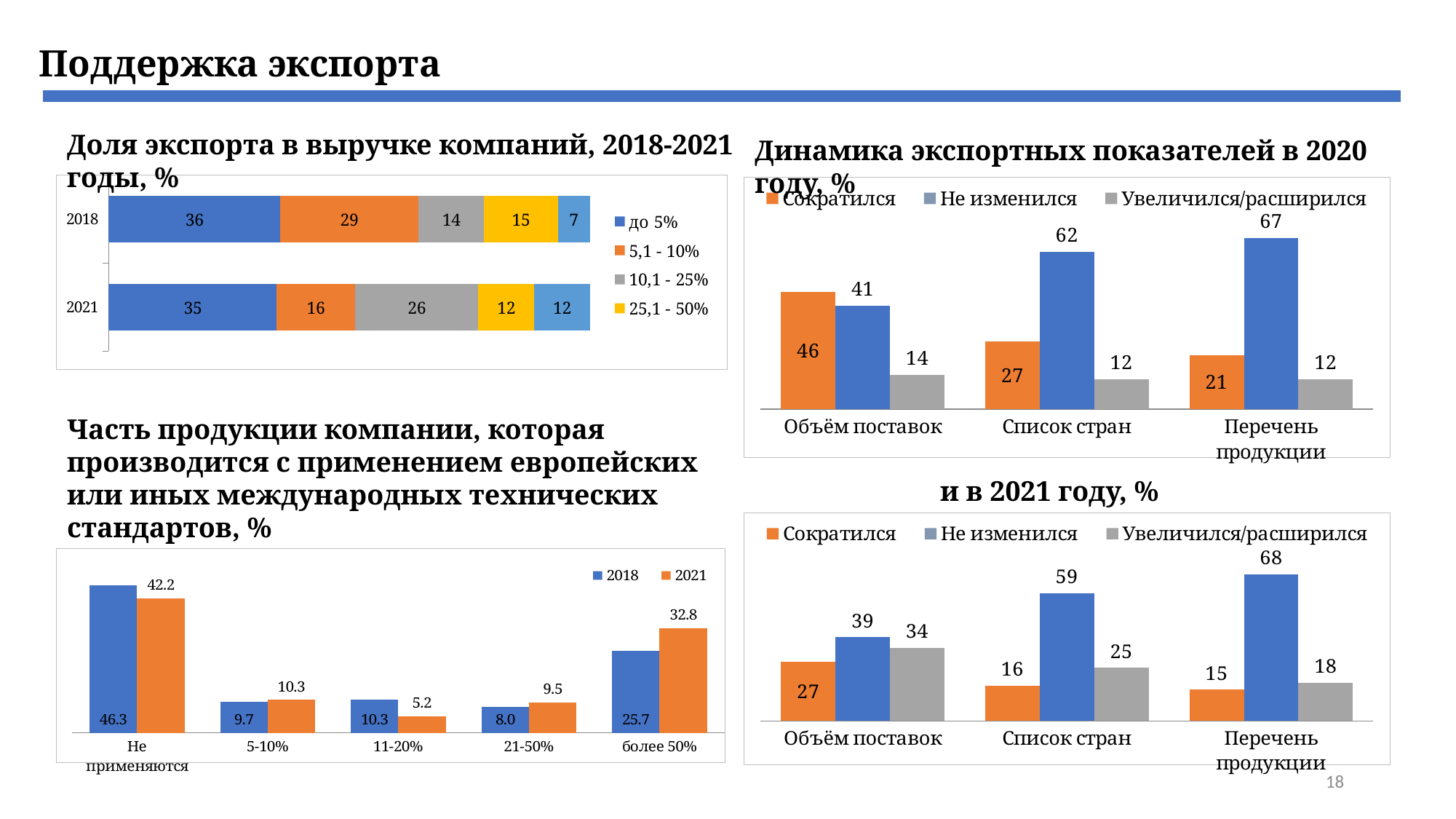
In the chart 'Доля экспорта в выручке компаний, 2018-2021 годы, %', what is the value of the 'до 5%' segment for 2018? 36 In the chart 'Динамика экспортных показателей в 2020 году, %', what is the 'Сократился' value for 'Объём поставок'? 46 In the chart 'Доля экспорта в выручке компаний, 2018-2021 годы, %', what is the total of the 2021 stacked bar? 101 In the chart 'Часть продукции компании, которая производится с применением европейских или иных международных технических стандартов, %', what is the 2021 value for 'более 50%'? 32.8 In the chart 'Часть продукции компании, которая производится с применением европейских или иных международных технических стандартов, %', what is the difference between the 2018 and 2021 values for '11-20%'? 5.1 How many series does the legend of the chart 'и в 2021 году, %' list? 3 What kind of chart is 'Доля экспорта в выручке компаний, 2018-2021 годы, %'? Stacked bar chart In the chart 'Доля экспорта в выручке компаний, 2018-2021 годы, %', what is the value of the '10,1 - 25%' segment for 2021? 26 In the chart 'Динамика экспортных показателей в 2020 году, %', which category has the highest 'Не изменился' value? Перечень продукции In the chart 'и в 2021 году, %', which is larger for 'Объём поставок': 'Не изменился' or 'Увеличился/расширился'? Не изменился How many categories are shown on the x axis of the chart 'Часть продукции компании, которая производится с применением европейских или иных международных технических стандартов, %'? 5 In the chart 'Часть продукции компании, которая производится с применением европейских или иных международных технических стандартов, %', which category has the highest 2018 value? Не применяются